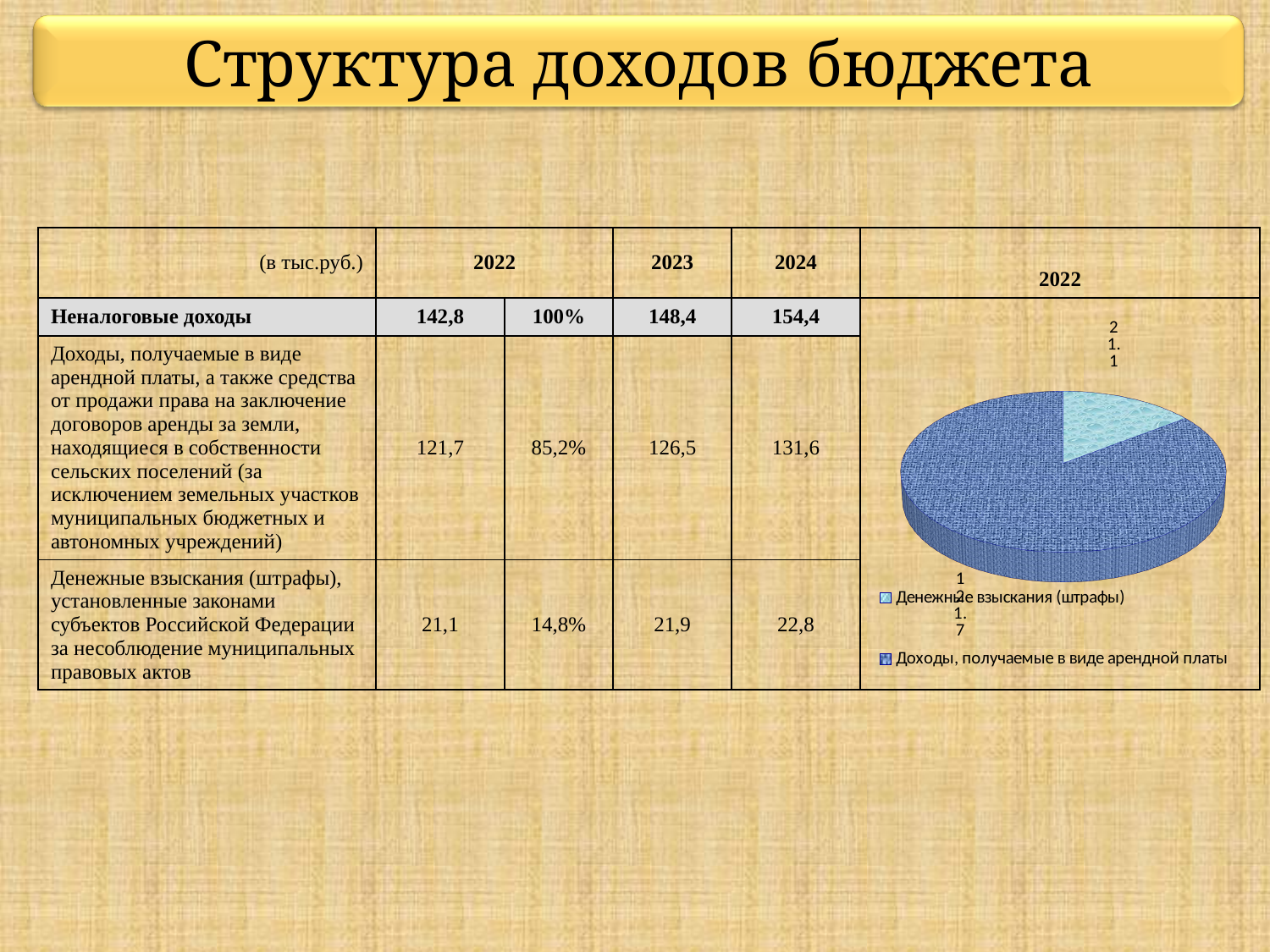
What colour is the slice for Денежные взыскания (штрафы) in the pie chart? light blue What value is labelled on the Денежные взыскания (штрафы) slice of the pie chart? 21.1 In the pie chart, which is larger: Денежные взыскания (штрафы) or Доходы, получаемые в виде арендной платы? Доходы, получаемые в виде арендной платы Which slice of the pie chart is the largest? Доходы, получаемые в виде арендной платы What is the title of the pie chart? 2022 How many slices does the pie chart have? 2 What value is labelled on the Доходы, получаемые в виде арендной платы slice of the pie chart? 121.7 How many entries does the legend of the pie chart list? 2 Which slice of the pie chart is the smallest? Денежные взыскания (штрафы) What kind of chart is shown on the slide? pie chart